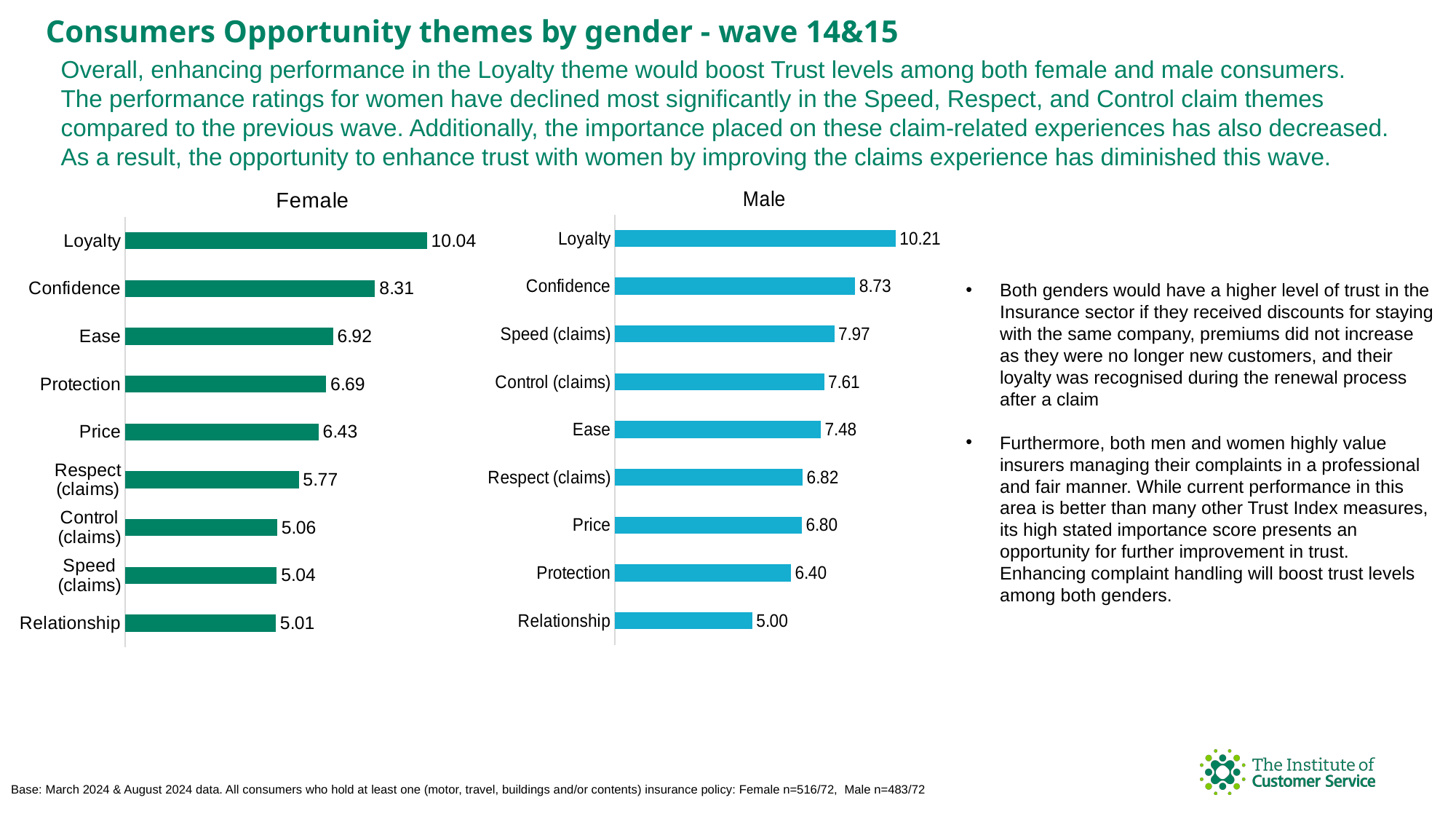
In the Male chart, what is the difference between Loyalty and Confidence? 1.48 In the Male chart, which category has the highest value? Loyalty In the Male chart, what is the value for Relationship? 5.00 How many categories are shown in the Female chart? 9 In the Female chart, what is the value for Control (claims)? 5.06 What kind of chart is the Male chart? Bar chart In the Male chart, what is the value for Speed (claims)? 7.97 In the Female chart, what is the difference between Ease and Protection? 0.23 In the Female chart, what is the value for Loyalty? 10.04 In the Female chart, which category has the lowest value? Relationship What colour are the bars in the Female chart? Dark green In the Male chart, which is larger: Ease or Price? Ease